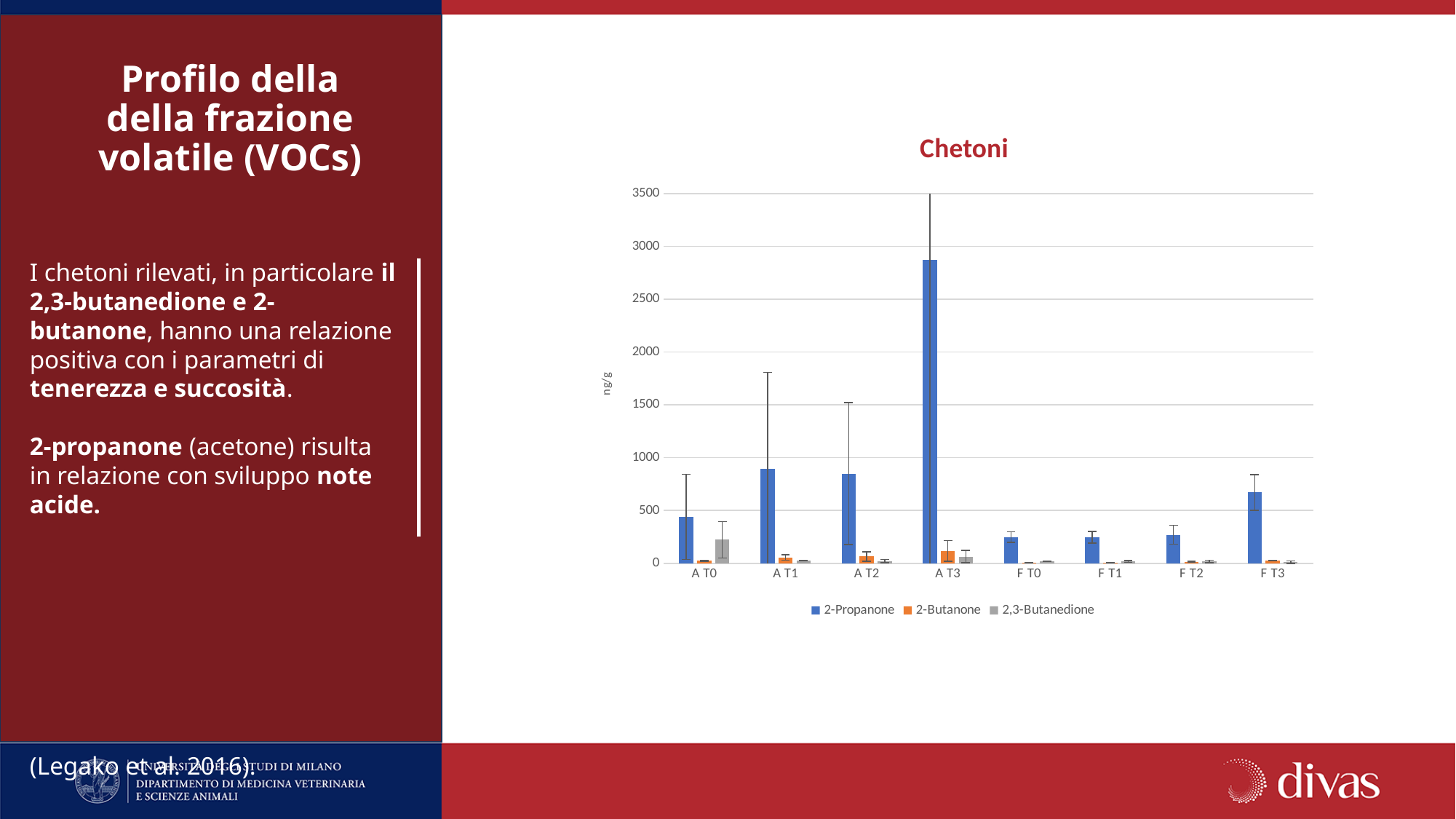
Is the 2-Propanone value for A T3 greater or less than 2500? greater What is the title of the chart? Chetoni Is the 2-Propanone value for F T3 greater or less than 500? greater Which category has the highest 2-Propanone value? A T3 Which category has the highest 2,3-Butanedione value? A T0 How many series does the legend list? 3 Is the 2-Propanone value for A T0 greater or less than 500? less What is the label of the y axis? ng/g What kind of chart is shown on the slide? bar chart Which is larger, the 2-Propanone value for A T3 or for F T0? A T3 How many categories are shown on the x axis? 8